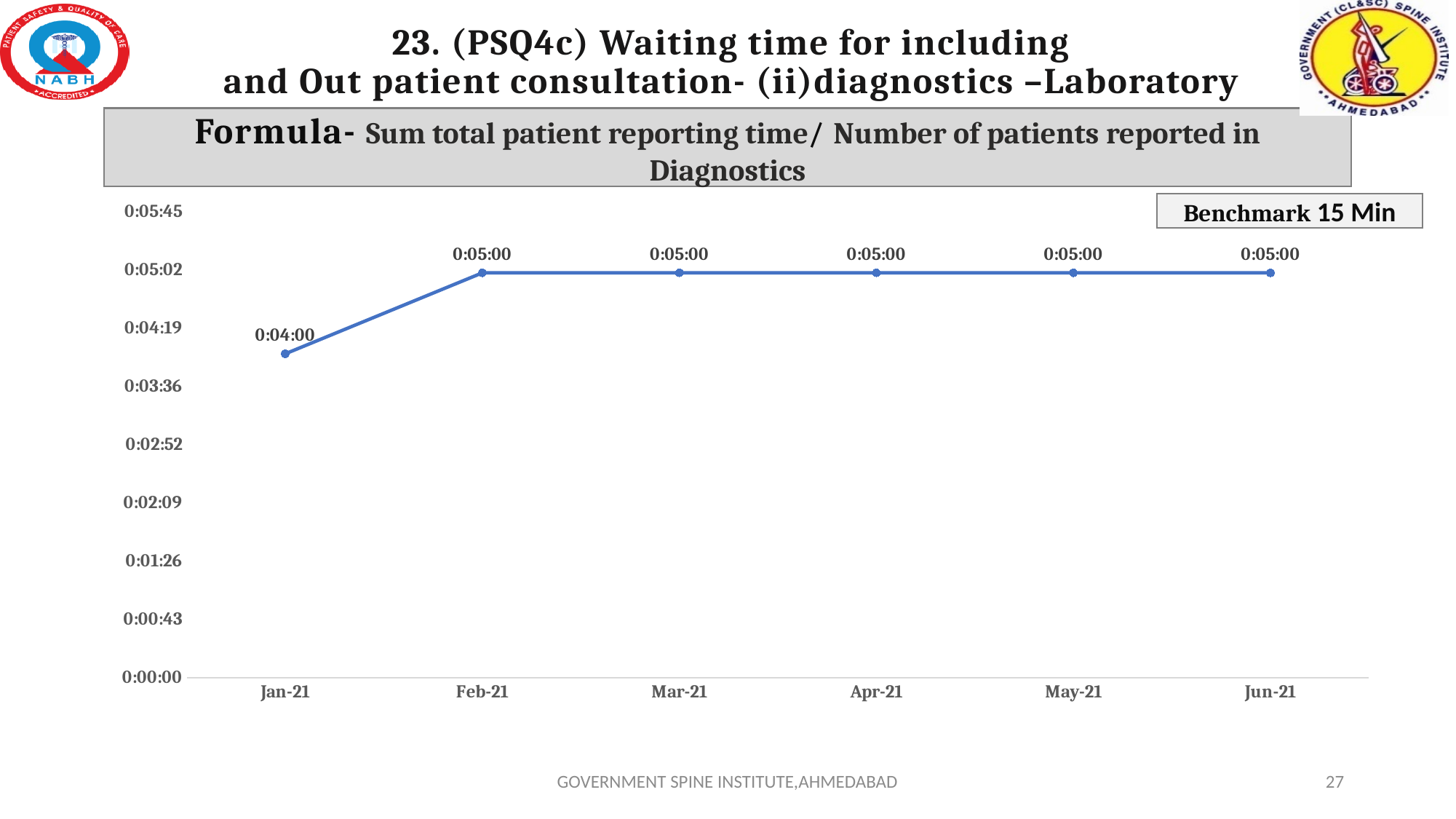
What is the value for Jun-21? 0:05:00 What benchmark is stated on the slide? 15 Min Does the value change between Feb-21 and Jun-21? No, it stays at 0:05:00 What is the value for Jan-21? 0:04:00 What kind of chart is shown on the slide? line chart Which is larger, the value for Jan-21 or the value for Mar-21? Mar-21 How many months are plotted on the x axis? 6 Does the value rise or fall from Jan-21 to Feb-21? rise Which month has the lowest value? Jan-21 How many months have a value of 0:05:00? 5 What is the value for Feb-21? 0:05:00 What is the value shown at the top of the y axis? 0:05:45